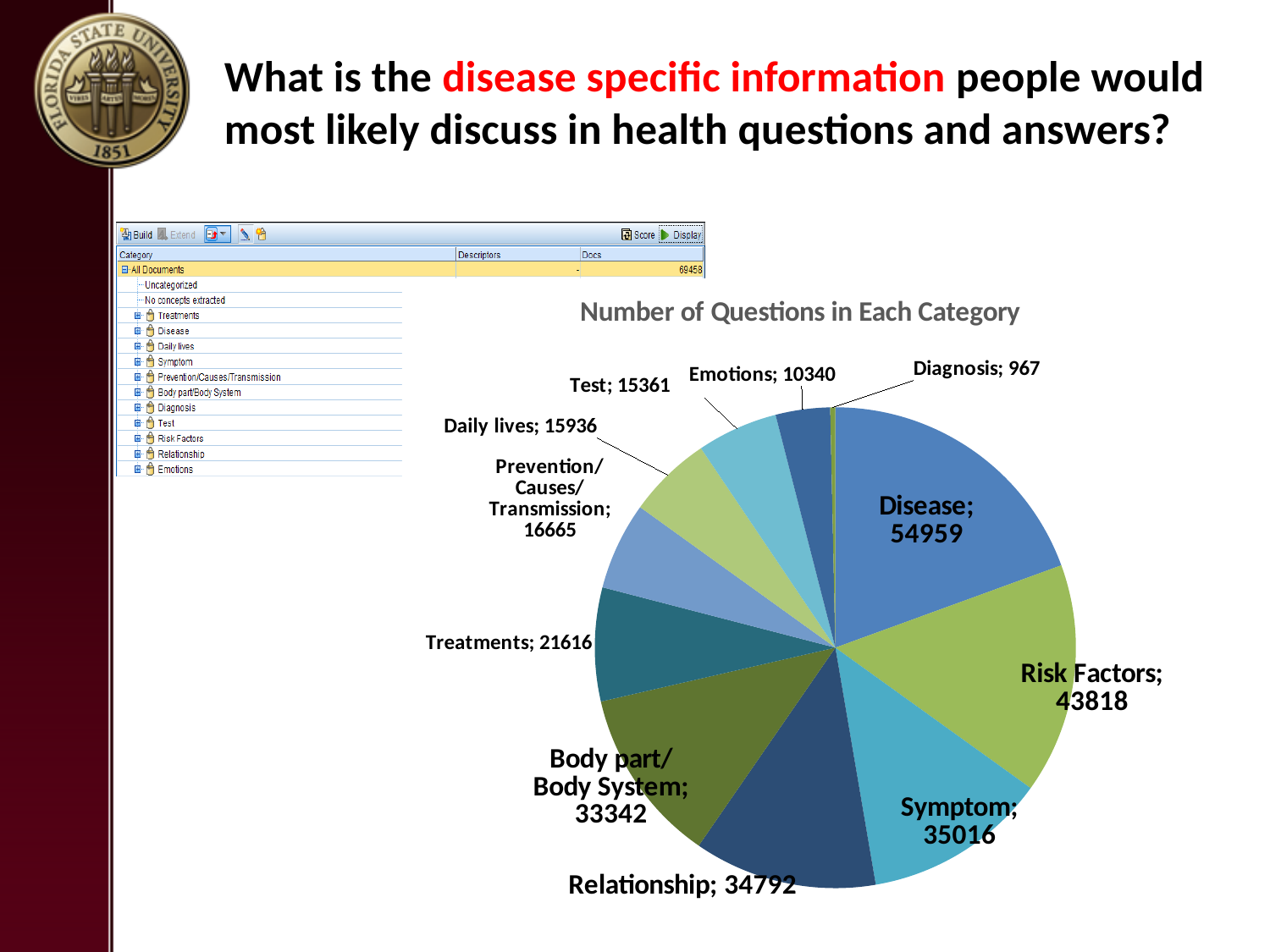
What is the difference between the number of questions for Treatments and for Emotions? 11276 How many categories does the pie chart show? 11 What is the number of questions in the Body part/Body System category? 33342 What is the difference between the number of questions for Disease and for Risk Factors? 11141 Which category has the largest number of questions? Disease What is the number of questions in the Disease category? 54959 What is the number of questions in the Diagnosis category? 967 What type of chart is shown on the slide? pie chart Which category has the smallest number of questions? Diagnosis What is the title of the chart? Number of Questions in Each Category What is the number of questions in the Risk Factors category? 43818 Which has more questions, Treatments or Emotions? Treatments